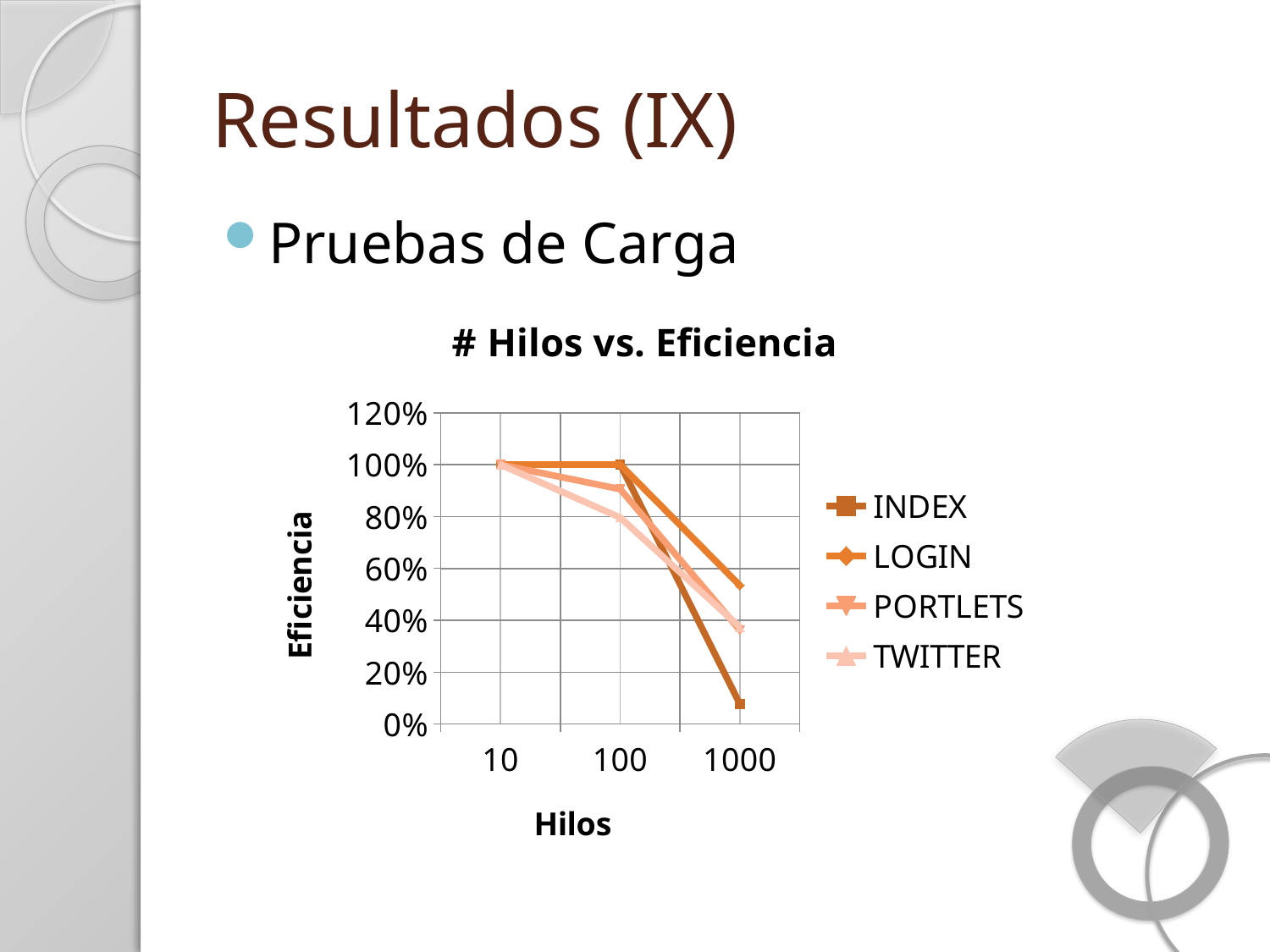
What is the efficiency of LOGIN at 100 threads (Hilos)? 100% Is the value for INDEX at 1000 threads greater or less than 20%? less What kind of chart is shown on the slide? line chart How many series does the legend list? 4 Which series has the highest efficiency at 1000 threads? LOGIN What is the title of the chart? # Hilos vs. Eficiencia At 100 threads, which series has the higher efficiency, INDEX or TWITTER? INDEX How many values are shown on the x axis (Hilos)? 3 Which series has the lowest efficiency at 1000 threads? INDEX Does the efficiency of INDEX rise or fall as the number of threads increases from 100 to 1000? fall What is the efficiency of INDEX at 10 threads (Hilos)? 100% Is the value for LOGIN at 1000 threads greater or less than 40%? greater